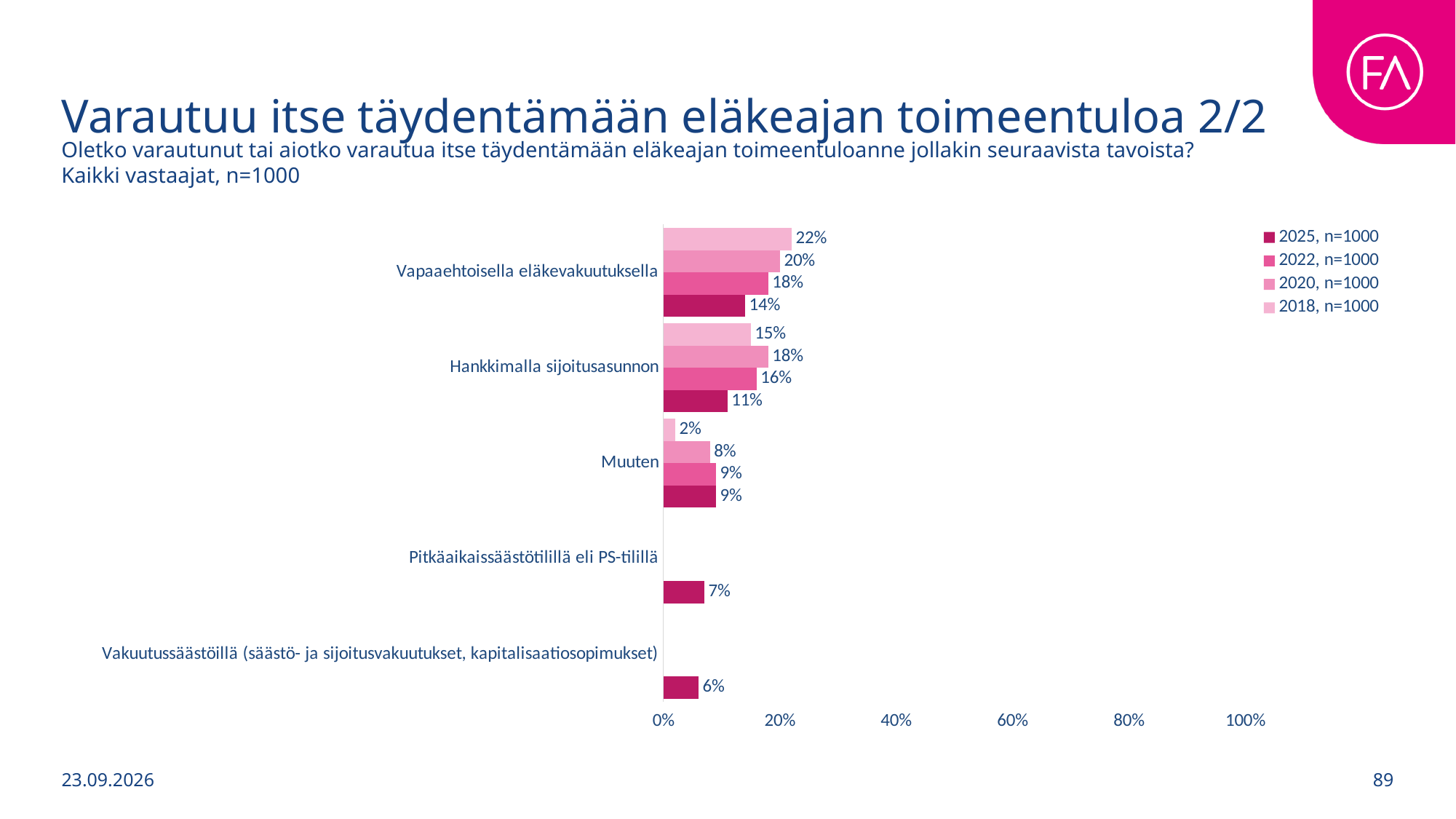
Which is larger for Hankkimalla sijoitusasunnon: the 2020 value or the 2025 value? 2020 What is the value for Hankkimalla sijoitusasunnon in the 2018 series? 15% What is the value for Vakuutussäästöillä (säästö- ja sijoitusvakuutukset, kapitalisaatiosopimukset) in the 2025 series? 6% Which category has the lowest value in the 2018 series? Muuten What is the value for Pitkäaikaissäästötilillä eli PS-tilillä in the 2025 series? 7% What is the value for Vapaaehtoisella eläkevakuutuksella in the 2025 series? 14% Which category has the highest value in the 2018 series? Vapaaehtoisella eläkevakuutuksella How many categories are shown on the chart? 5 What kind of chart is shown on the slide? bar chart Which series is shown in the darkest colour in the legend? 2025, n=1000 How many series does the legend list? 4 What is the difference between the 2018 and 2025 values for Vapaaehtoisella eläkevakuutuksella? 8 percentage points